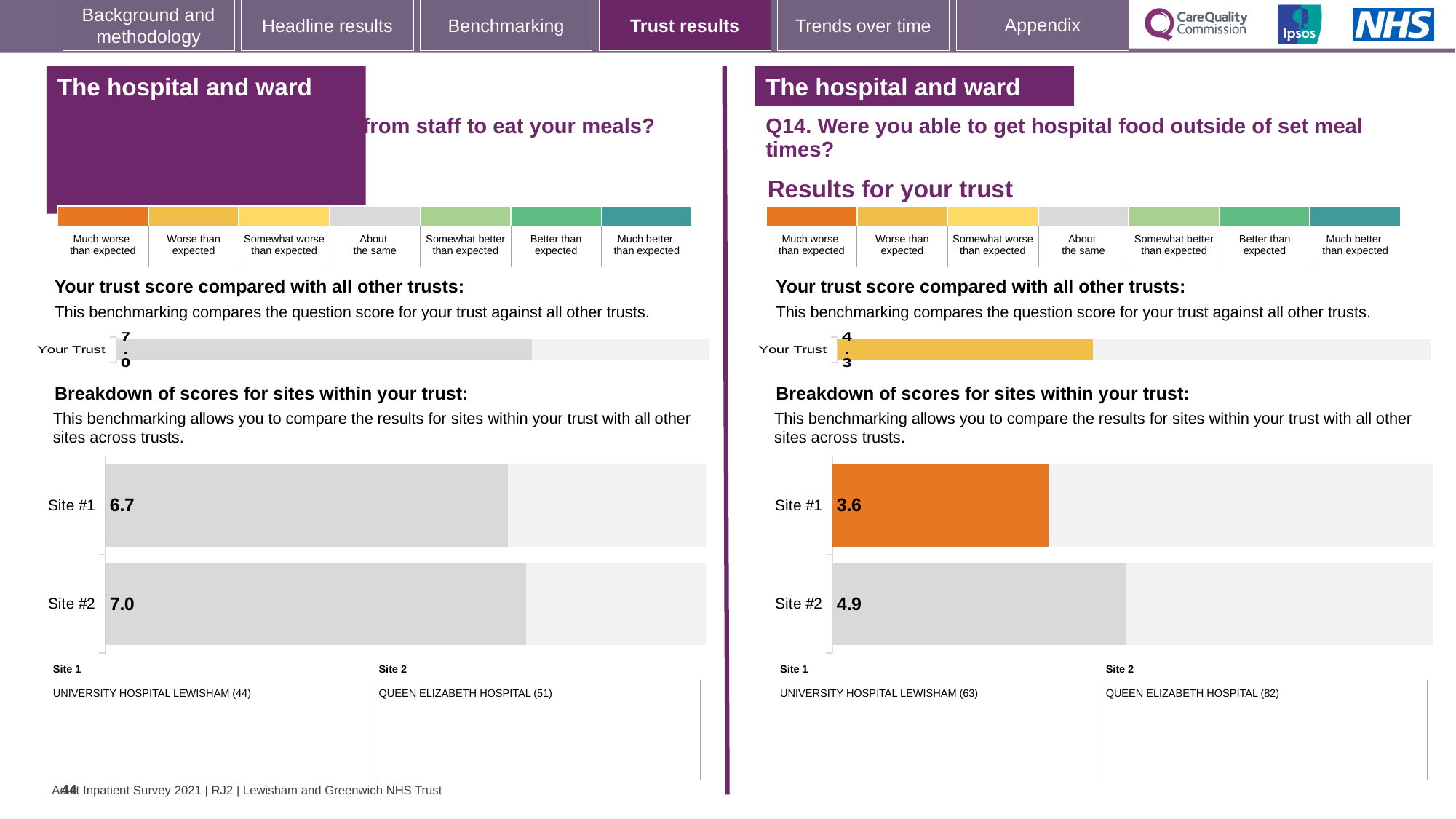
On the site breakdown chart on the left half of the slide, what is the score for Site #2? 7.0 On the site breakdown chart on the left half of the slide, what is the difference between the Site #2 and Site #1 scores? 0.3 On the Q14 site breakdown chart on the right half of the slide, what is the score for Site #1? 3.6 On the site breakdown chart on the left half of the slide, what is the score for Site #1? 6.7 On the 'Your trust score compared with all other trusts' chart on the left half of the slide, what is the value shown for Your Trust? 7.0 On the Q14 site breakdown chart on the right half of the slide, which site has the higher score? Site #2 On the site breakdown chart on the left half of the slide, which site has the lower score? Site #1 What type of chart is used for the Q14 site breakdown on the right half of the slide? Bar chart On the Q14 site breakdown chart on the right half of the slide, what is the difference between the Site #2 and Site #1 scores? 1.3 On the Q14 'Your trust score compared with all other trusts' chart on the right half of the slide, what is the value shown for Your Trust? 4.3 How many sites are shown on the Q14 site breakdown chart on the right half of the slide? 2 On the Q14 site breakdown chart on the right half of the slide, what is the score for Site #2? 4.9